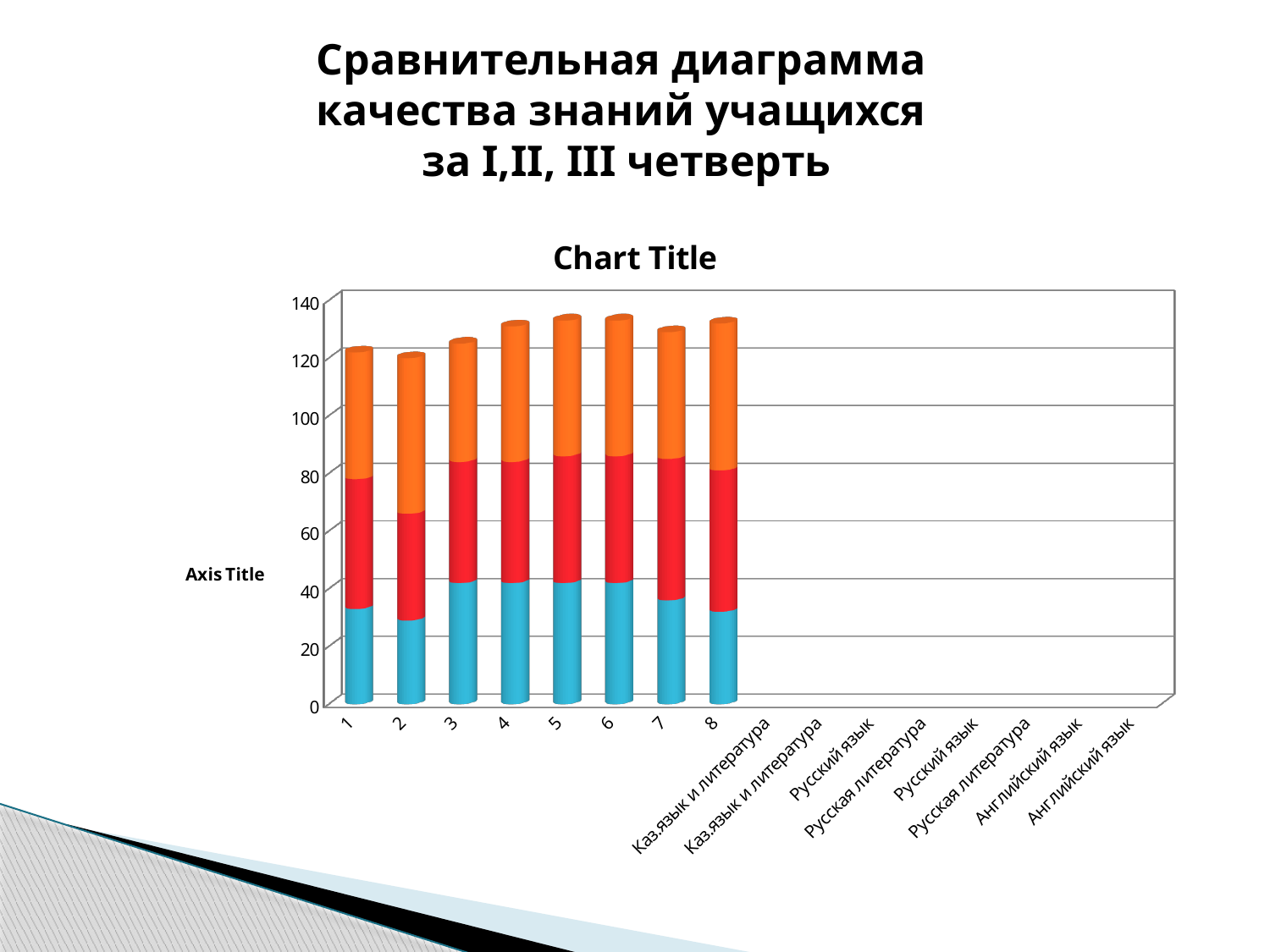
Which bar has the larger blue (bottom) segment, bar 2 or bar 4? Bar 4 Do the bar totals rise or fall from category 2 to category 5? Rise How many coloured segments make up each bar? 3 Is the total height of bar 2 greater or less than 100? greater Is the total height of bar 2 greater or less than 140? less Is the blue (bottom) segment of bar 2 greater or less than 40? less What kind of chart is shown on the slide? Stacked bar chart What is the title printed above the chart? Chart Title Which bar has the greater total height, bar 2 or bar 5? Bar 5 How many bars are plotted on the chart? 8